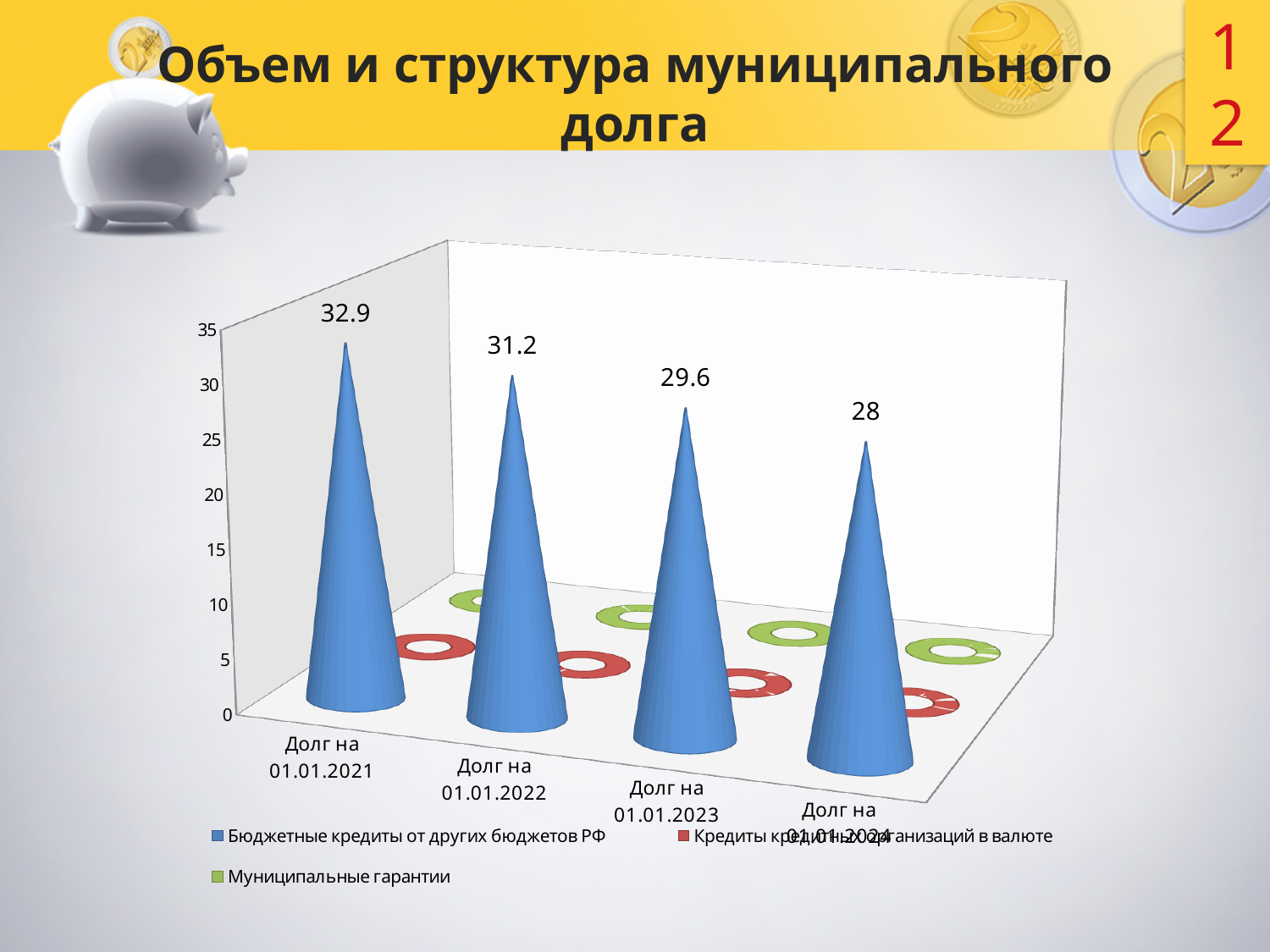
What is the value of the blue series for Долг на 01.01.2022? 31.2 Which is larger for the blue series: Долг на 01.01.2022 or Долг на 01.01.2023? Долг на 01.01.2022 What is the difference between the blue series values for Долг на 01.01.2021 and Долг на 01.01.2024? 4.9 What is the value of the blue series (Бюджетные кредиты от других бюджетов РФ) for Долг на 01.01.2021? 32.9 How many series does the chart legend list? 3 Which category has the lowest value for the blue series (Бюджетные кредиты от других бюджетов РФ)? Долг на 01.01.2024 How many categories are shown on the x axis of the chart? 4 Which category has the highest value for the blue series (Бюджетные кредиты от других бюджетов РФ)? Долг на 01.01.2021 What is the value of the blue series for Долг на 01.01.2024? 28 Do the values of the blue series rise or fall from Долг на 01.01.2021 to Долг на 01.01.2024? fall What is the value of the blue series for Долг на 01.01.2023? 29.6 Is the blue series value for Долг на 01.01.2024 greater or less than 30? less